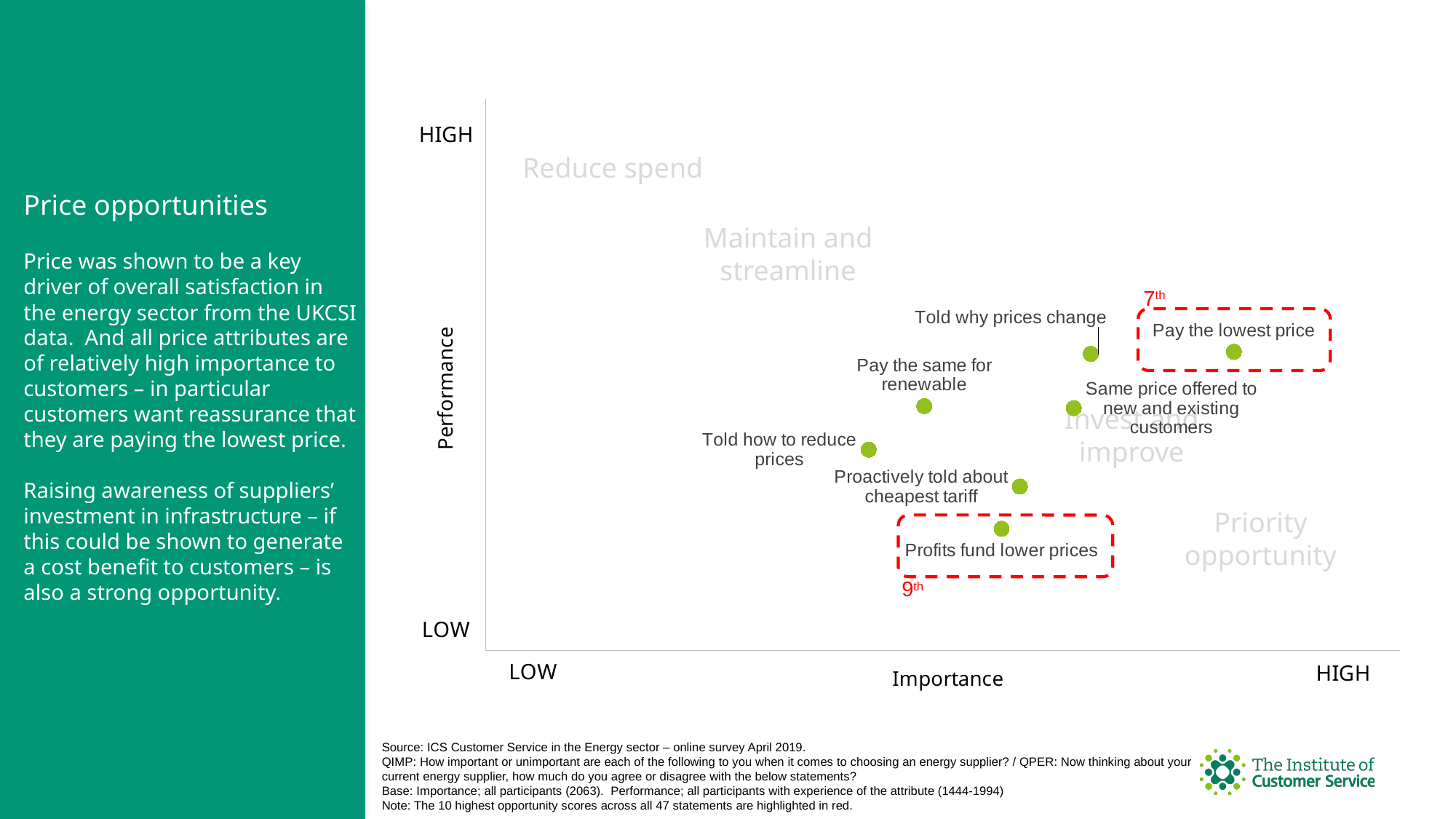
Which has higher performance: 'Pay the same for renewable' or 'Proactively told about cheapest tariff'? Pay the same for renewable Which plotted attribute has the lowest performance? Profits fund lower prices What kind of chart is shown on the slide? Scatter chart What opportunity rank is shown next to 'Profits fund lower prices'? 9th What is the label of the vertical axis? Performance Which has higher importance: 'Pay the lowest price' or 'Told how to reduce prices'? Pay the lowest price Which plotted attribute has the highest importance? Pay the lowest price What opportunity rank is shown next to 'Pay the lowest price'? 7th Which plotted attribute has the lowest importance? Told how to reduce prices Which has higher performance: 'Told why prices change' or 'Profits fund lower prices'? Told why prices change How many data points are plotted on the chart? 7 What is the label of the horizontal axis? Importance